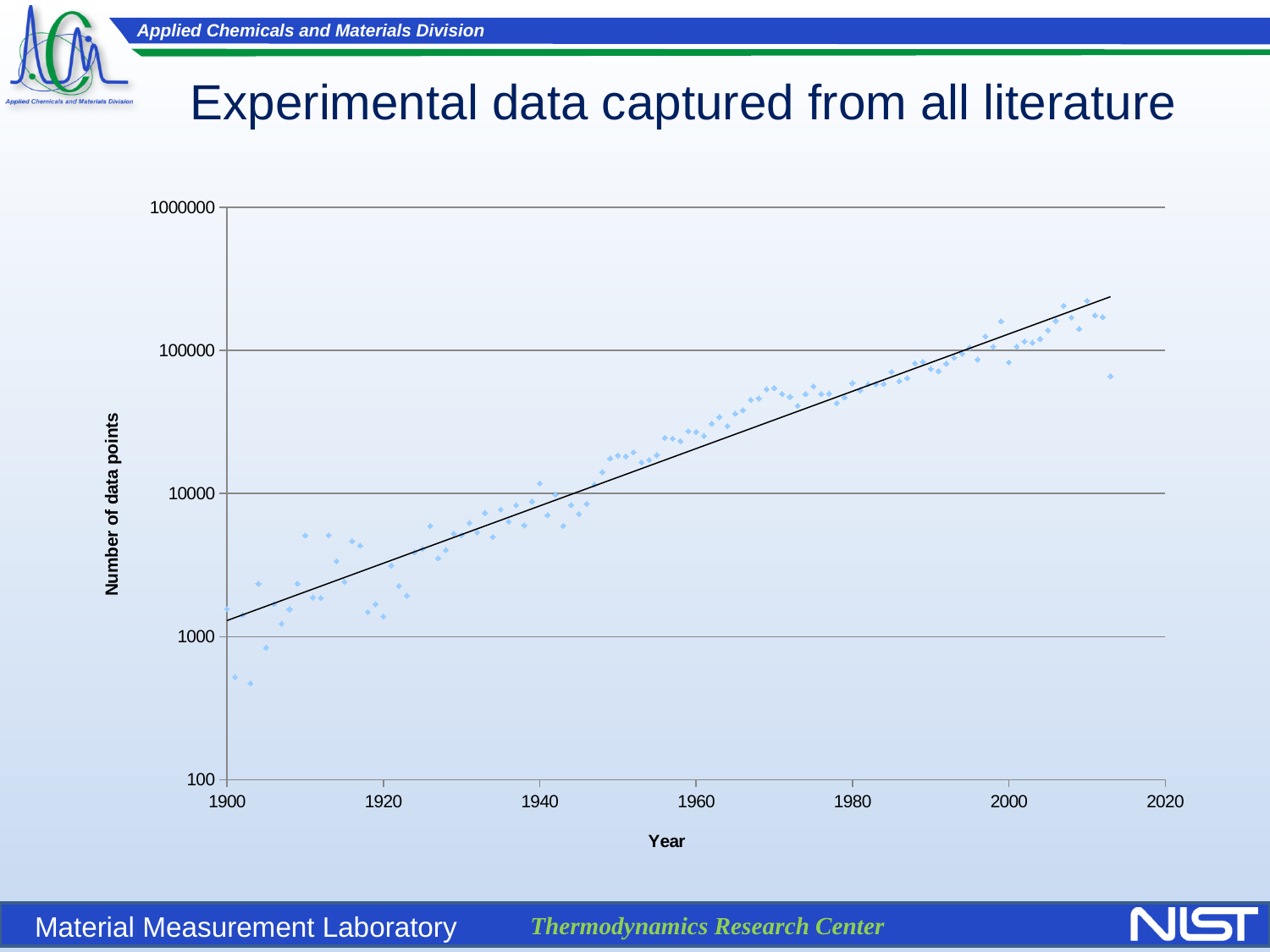
Is the number of data points for the year 1980 greater or less than 10000? greater Is the number of data points for the year 1960 greater or less than 100000? less Is the number of data points for the year 1920 greater or less than 10000? less What kind of chart is shown on the slide? scatter chart What is the title of the x axis? Year What is the title of the y axis? Number of data points What is the highest value shown on the y axis? 1000000 Do the number of data points generally rise or fall as the year increases? rise